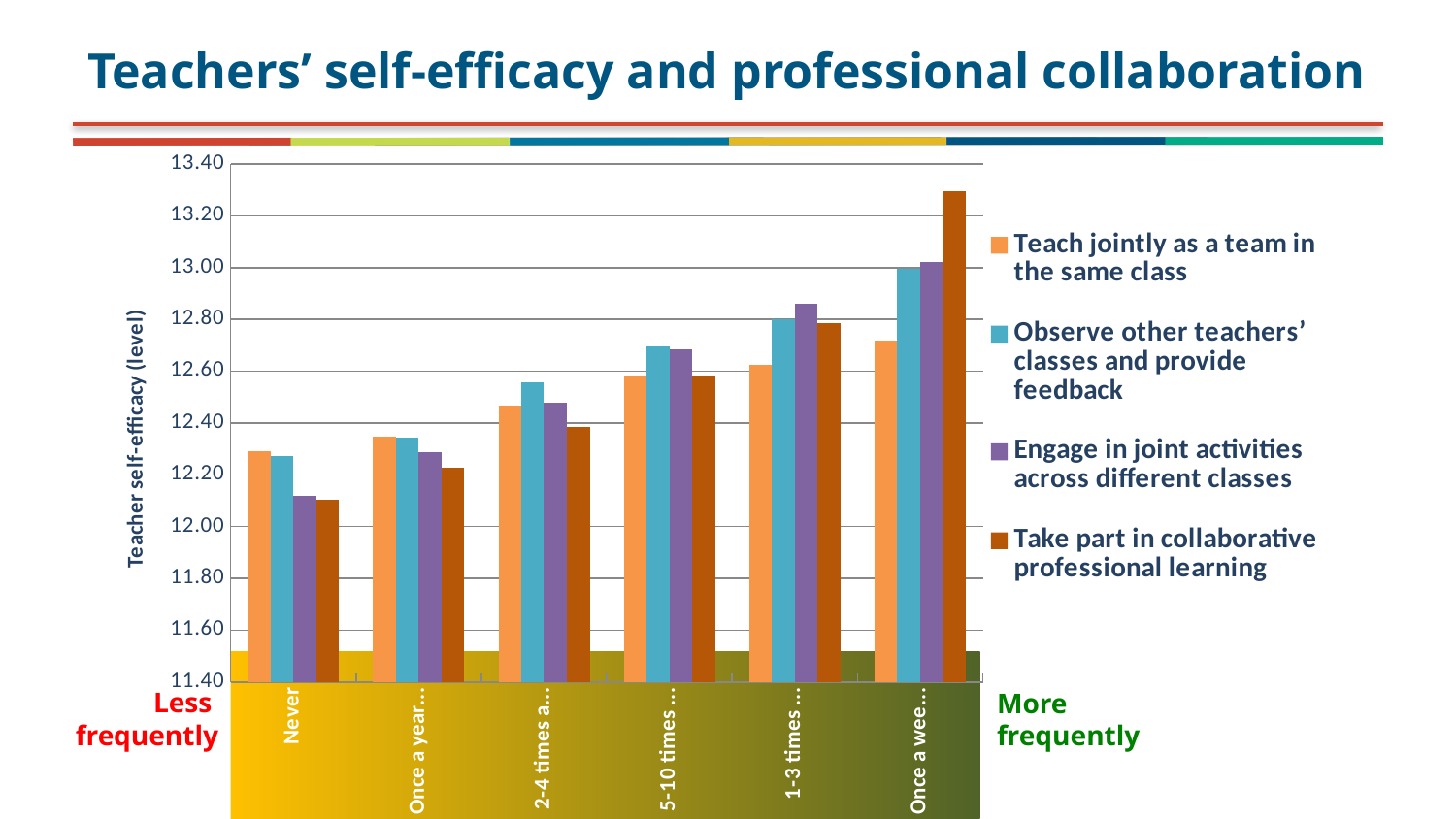
Which category has the lowest value for 'Engage in joint activities across different classes'? Never Is the value for 'Take part in collaborative professional learning' in the 'Never' category greater or less than 12.20? less What kind of chart is shown on the slide? Bar chart Is the value for 'Engage in joint activities across different classes' in the '1-3 times ...' category greater or less than 12.80? greater Do the values for 'Take part in collaborative professional learning' rise or fall as collaboration becomes more frequent along the x axis? Rise What is the label of the vertical axis? Teacher self-efficacy (level) Is the value for 'Take part in collaborative professional learning' in the 'Once a wee...' category greater or less than 13.20? greater How many frequency categories are shown along the x axis? 6 In the 'Never' category, which is larger: 'Teach jointly as a team in the same class' or 'Take part in collaborative professional learning'? Teach jointly as a team in the same class Which category has the highest value for 'Take part in collaborative professional learning'? Once a wee... (the rightmost category) How many series does the legend list? 4